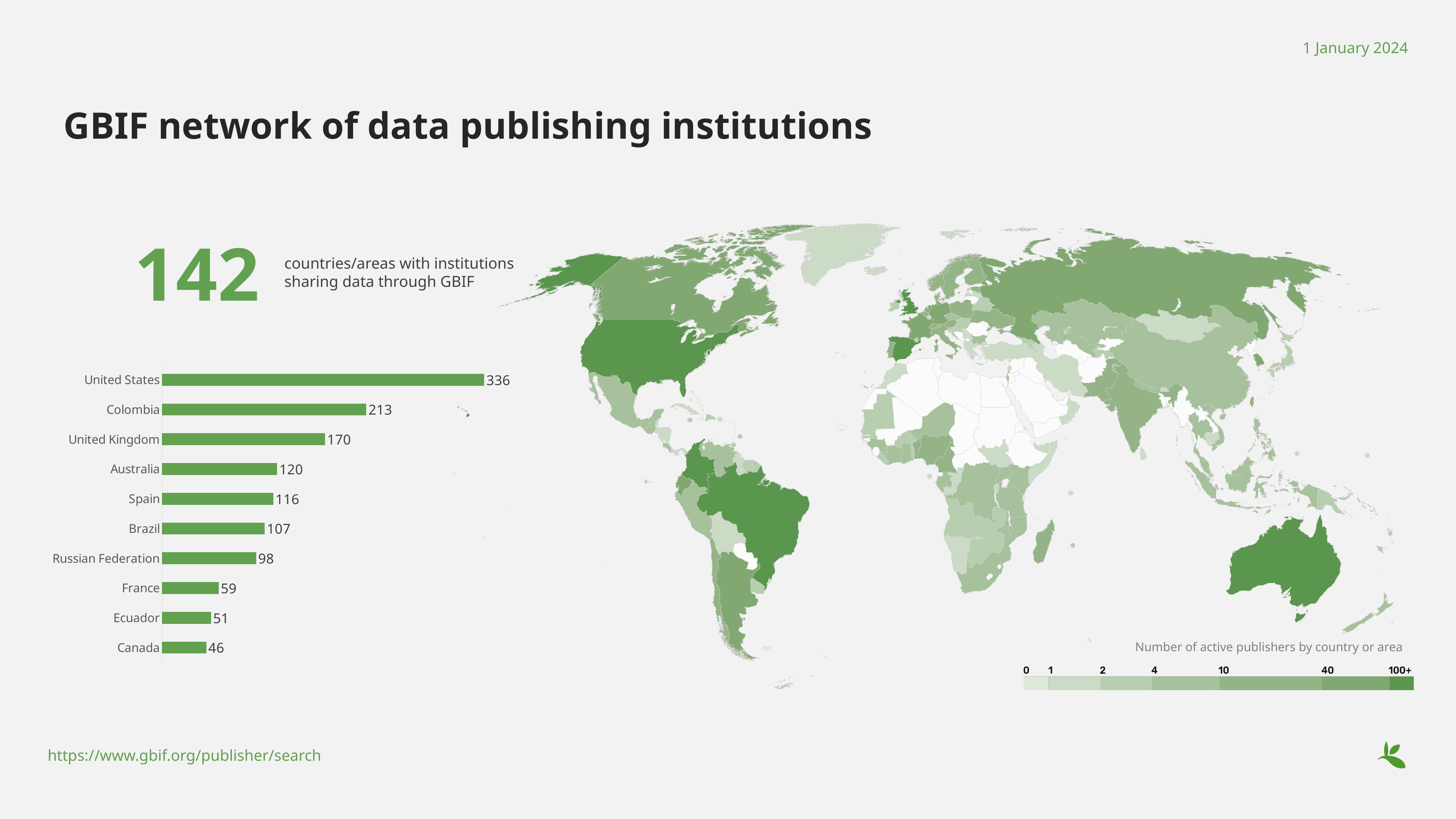
In the bar chart on the left, what is the value for the Russian Federation? 98 In the bar chart on the left, how many active publishers does the United States have? 336 In the bar chart on the left, which country has the highest number of active publishers? United States What kind of chart is shown on the left of the slide? Bar chart How many countries are listed in the bar chart on the left? 10 In the bar chart on the left, what is the value for Colombia? 213 In the bar chart on the left, what is the difference between the values for the United States and Colombia? 123 In the bar chart on the left, which country has the lowest value shown? Canada In the bar chart on the left, which has a larger value, Brazil or the United Kingdom? United Kingdom In the bar chart on the left, what is the difference between the values for Australia and Spain? 4 In the bar chart on the left, which has a larger value, France or Ecuador? France According to the large number on the slide, how many countries/areas have institutions sharing data through GBIF? 142